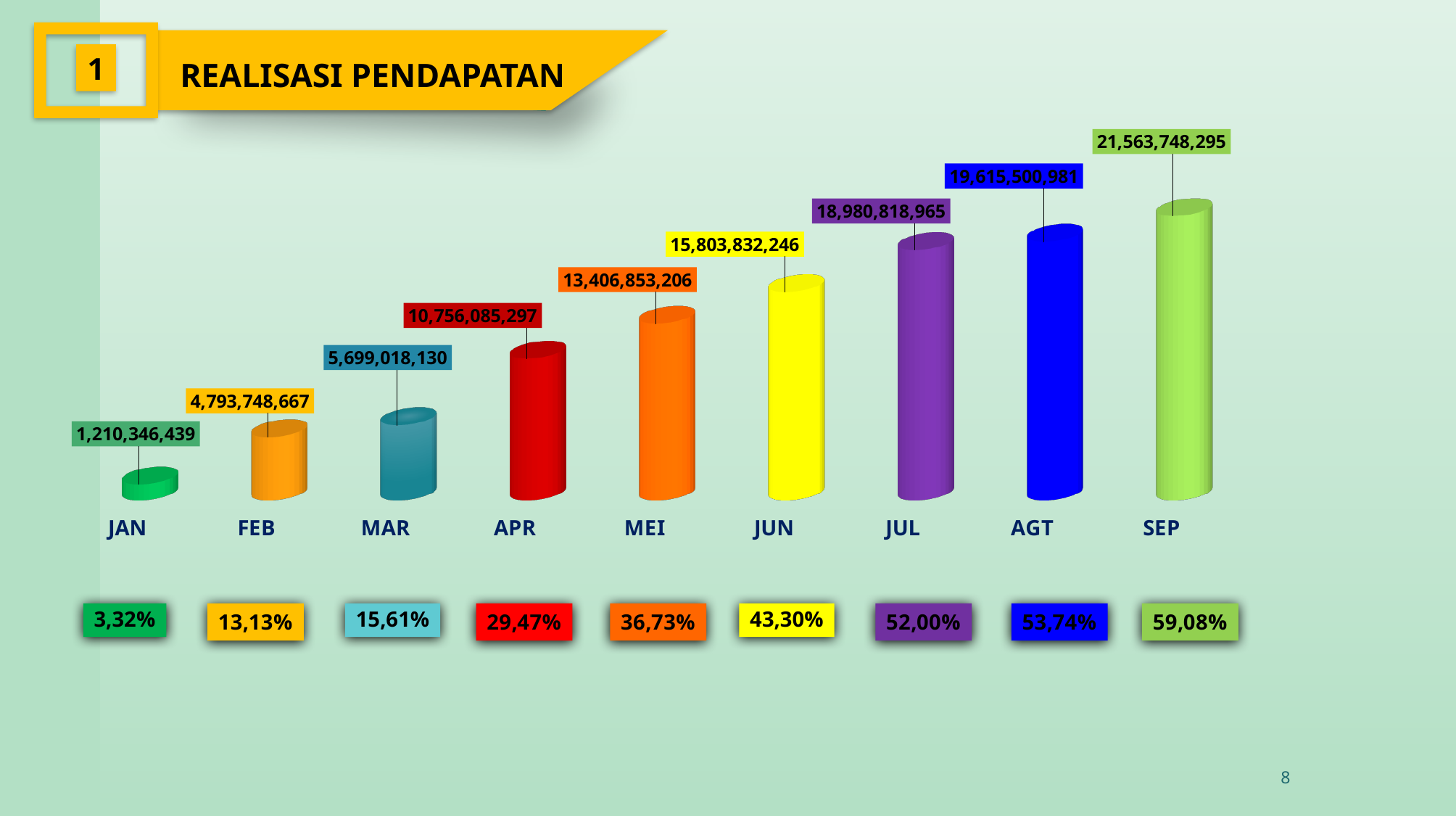
How many months are plotted on the chart? 9 What percentage is shown below JUL? 52,00% Which is larger, the value for APR or the value for MAR? APR What is the difference between the values for SEP and AGT? 1,948,247,314 What is the value for SEP? 21,563,748,295 Which month has the highest value? SEP What is the title of the chart? REALISASI PENDAPATAN Which month has the lowest value? JAN What is the value for MEI? 13,406,853,206 Do the values rise or fall from JAN to SEP? rise What is the value for JAN? 1,210,346,439 What type of chart is shown on the slide? bar chart